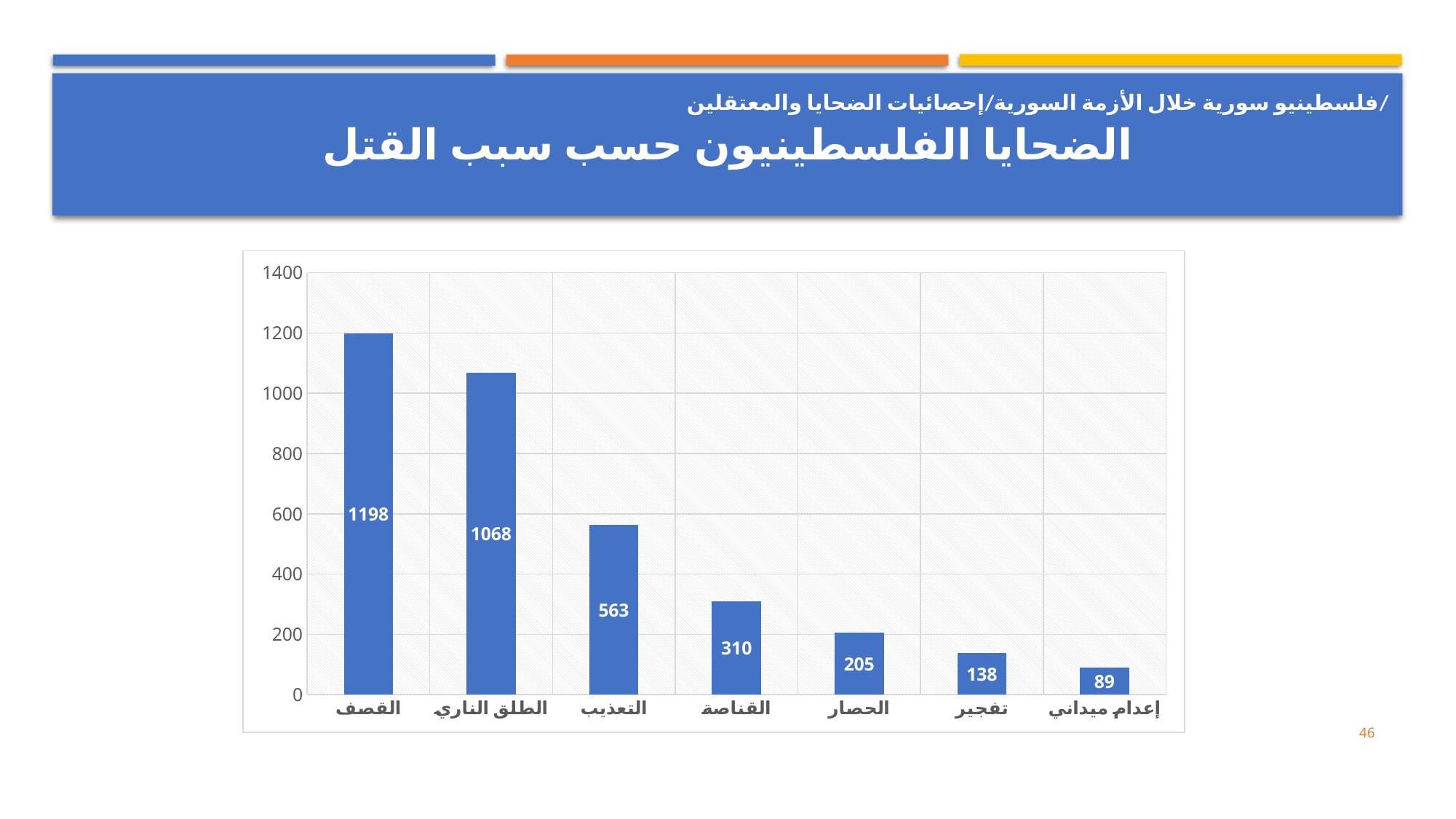
Which category has the highest value? القصف Which category has the lowest value? إعدام ميداني What is the difference between the values for القصف and الطلق الناري? 130 What is the value for إعدام ميداني? 89 Do the values rise or fall from left to right along the x axis? fall Which is larger, the value for القناصة or the value for الحصار? القناصة What is the value for القصف? 1198 What is the value for الطلق الناري? 1068 What is the value for التعذيب? 563 How many categories are shown on the x axis? 7 What kind of chart is shown on the slide? bar chart Is the value for التعذيب greater or less than 600? less